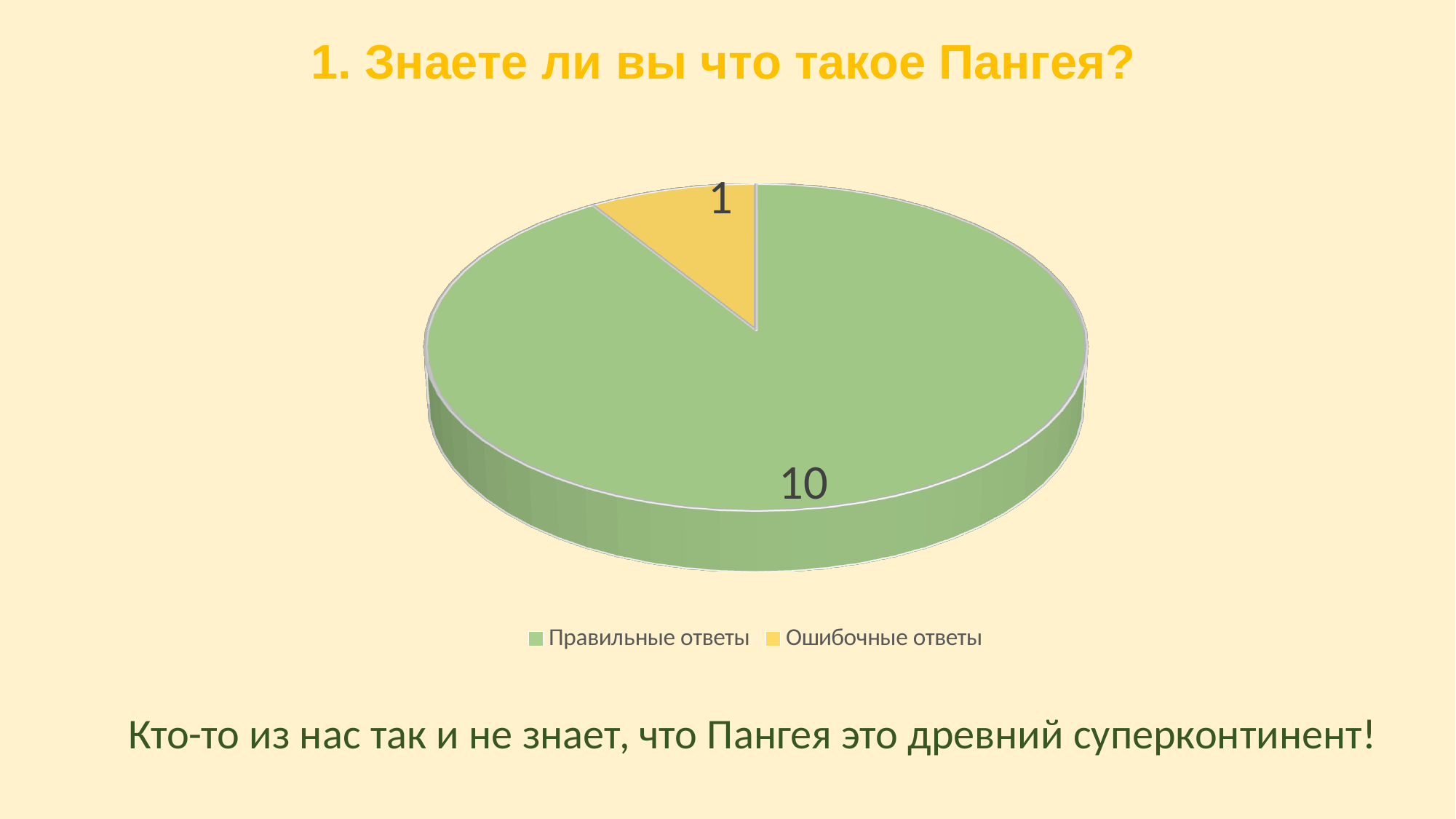
What is the difference between the values for Правильные ответы and Ошибочные ответы? 9 Which category has the largest slice? Правильные ответы What is the total of all slices in the pie chart? 11 How many slices does the pie chart have? 2 What colour is the slice for Ошибочные ответы? yellow Which is larger, the value for Правильные ответы or the value for Ошибочные ответы? Правильные ответы What is the value for Правильные ответы? 10 Which category has the smallest slice? Ошибочные ответы What kind of chart is shown on the slide? pie chart What is the value for Ошибочные ответы? 1 What is the title of the chart? 1. Знаете ли вы что такое Пангея? How many entries does the legend list? 2